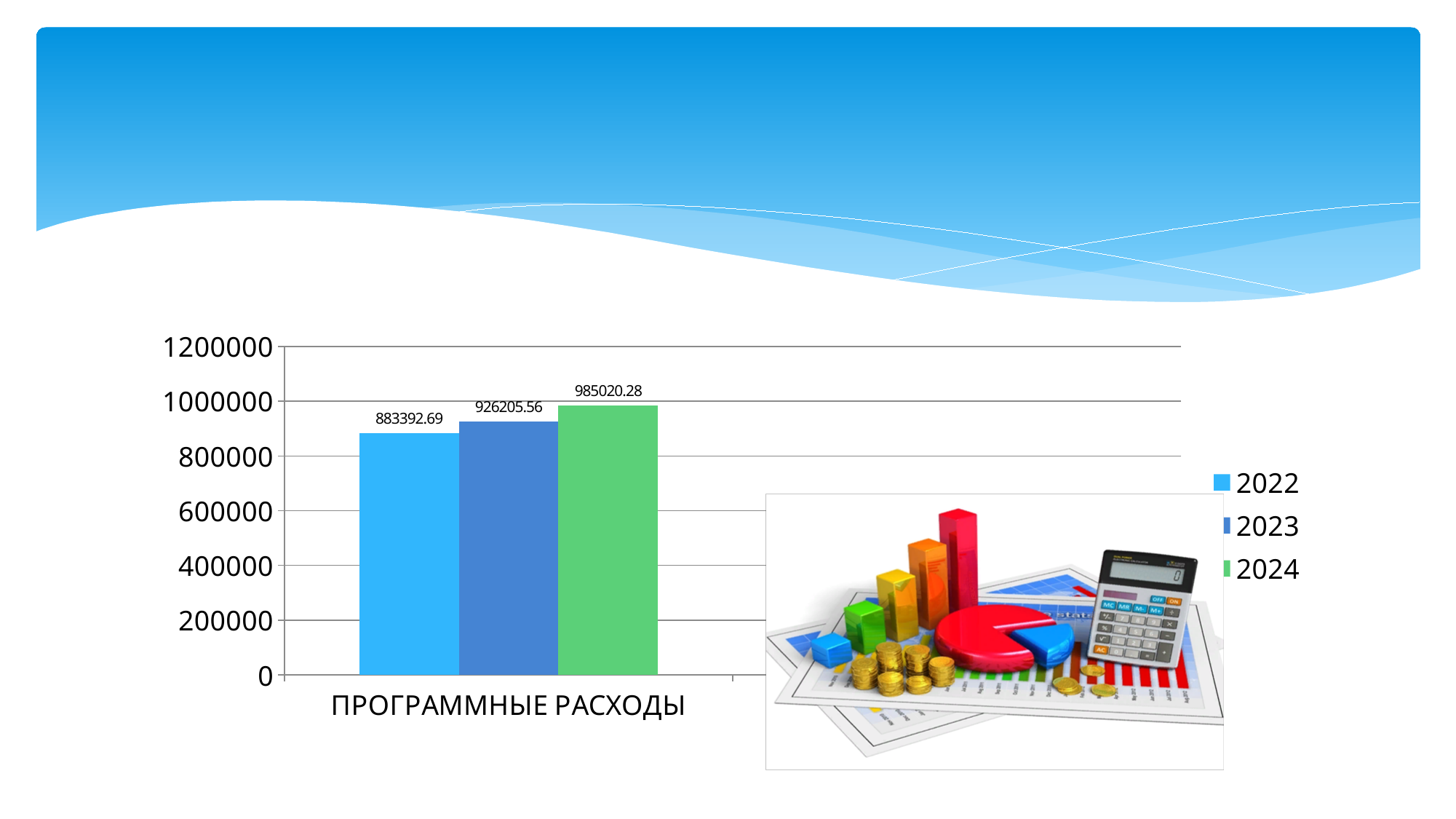
What is the value for 2023 in the ПРОГРАММНЫЕ РАСХОДЫ chart? 926205.56 What is the value for 2022 in the ПРОГРАММНЫЕ РАСХОДЫ chart? 883392.69 What is the difference between the 2023 and 2022 values for ПРОГРАММНЫЕ РАСХОДЫ? 42812.87 Which year has the lowest value for ПРОГРАММНЫЕ РАСХОДЫ? 2022 Which is larger, the 2023 value or the 2024 value for ПРОГРАММНЫЕ РАСХОДЫ? 2024 What is the difference between the 2024 and 2022 values for ПРОГРАММНЫЕ РАСХОДЫ? 101627.59 How many series does the legend list? 3 What kind of chart is shown on the slide? bar chart Is the value for 2022 greater or less than 1000000? less Do the values rise or fall from 2022 to 2024? rise What is the value for 2024 in the ПРОГРАММНЫЕ РАСХОДЫ chart? 985020.28 Which year has the highest value for ПРОГРАММНЫЕ РАСХОДЫ? 2024